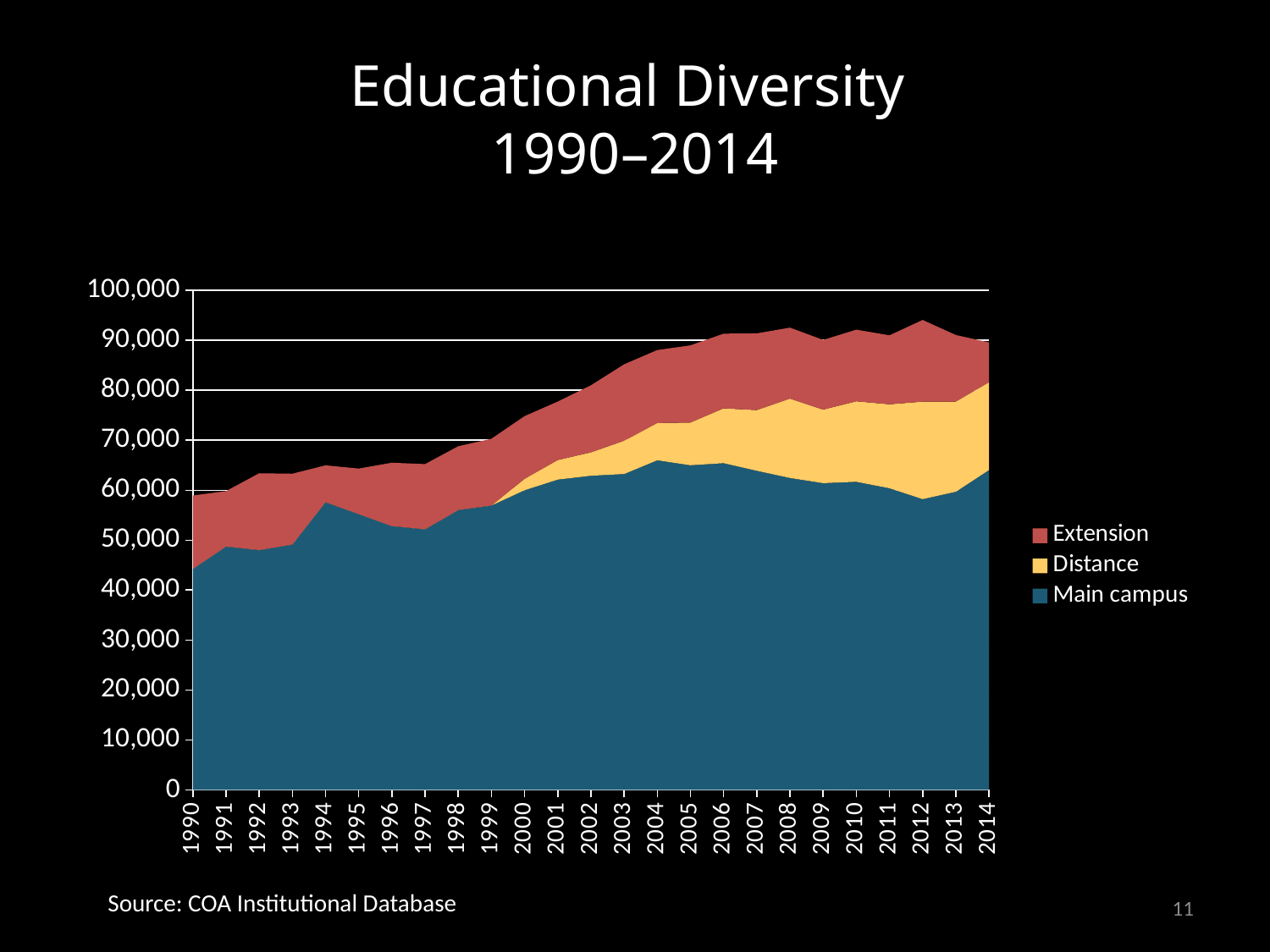
Is the total of all three series in 1990 greater or less than 70,000? less Is the Main campus value for 2004 greater or less than 60,000? greater Which series is shown in yellow? Distance What kind of chart is shown on the slide? Stacked area chart Is the total of all three series in 2014 greater or less than 80,000? greater How many series does the legend list? 3 Which series accounts for the largest share of the total throughout the period? Main campus Does the total of all series generally rise or fall from 1990 to 2014? Rise How many years are shown along the x axis? 25 What is the title of the chart? Educational Diversity 1990–2014